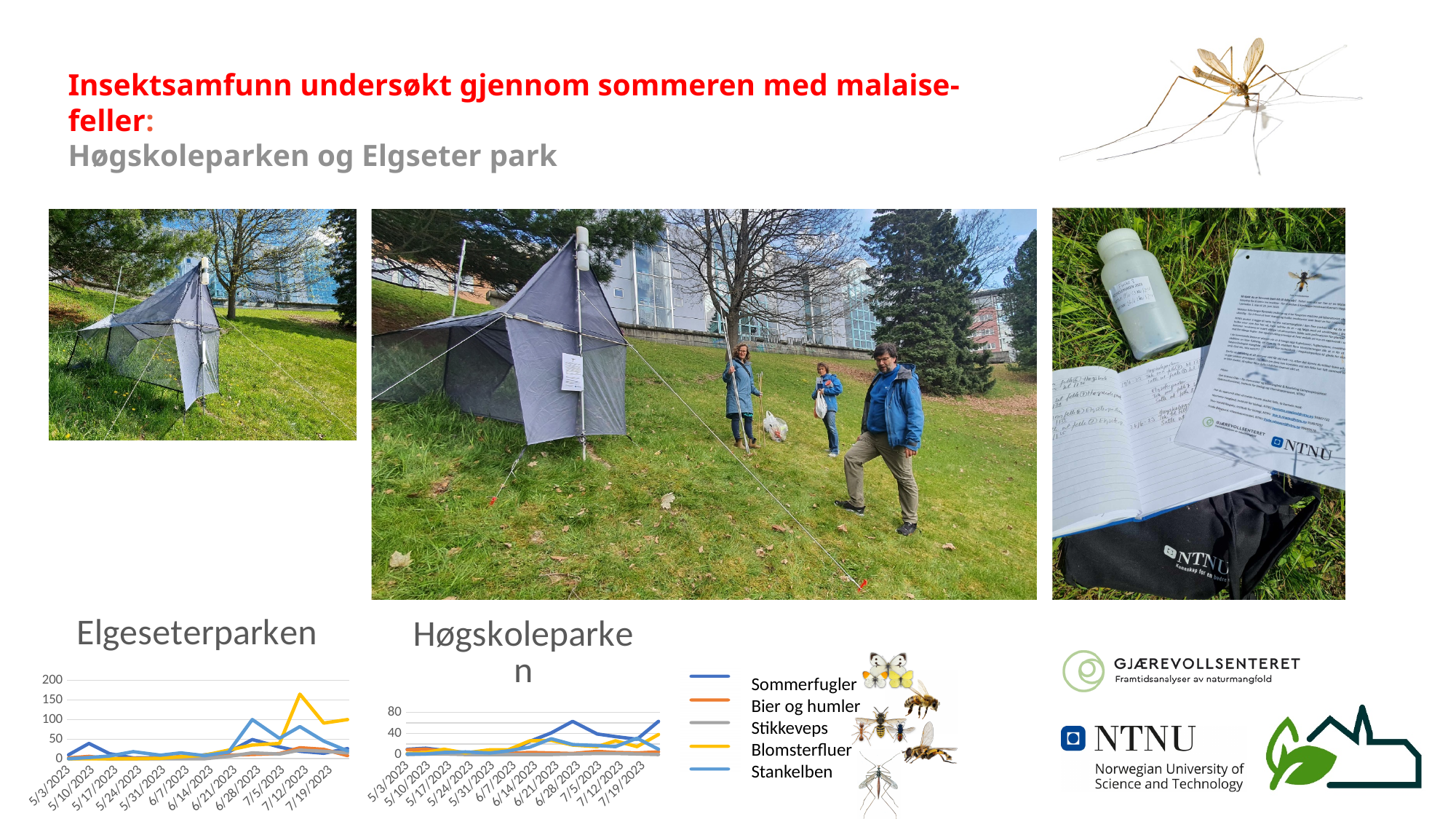
In the Elgeseterparken chart, which series reaches the highest peak? Blomsterfluer In the Elgeseterparken chart, on which date does Blomsterfluer reach its highest value? 7/12/2023 In the Høgskoleparken chart, which is larger on 7/19/2023: Sommerfugler or Blomsterfluer? Sommerfugler How many dates are plotted along the x axis of the Høgskoleparken chart? 12 In the Høgskoleparken chart, is the value for Sommerfugler on 6/28/2023 greater or less than 40? greater What kind of chart is the Elgeseterparken chart? line chart In the Elgeseterparken chart, does the Blomsterfluer line rise or fall from 7/12/2023 to 7/19/2023? fall In the Elgeseterparken chart, is the value for Blomsterfluer on 7/12/2023 greater or less than 150? greater What is the highest value shown on the y axis of the Elgeseterparken chart? 200 How many series does the legend shared by the two charts list? 5 In the Elgeseterparken chart, which is larger on 7/12/2023: Blomsterfluer or Stankelben? Blomsterfluer